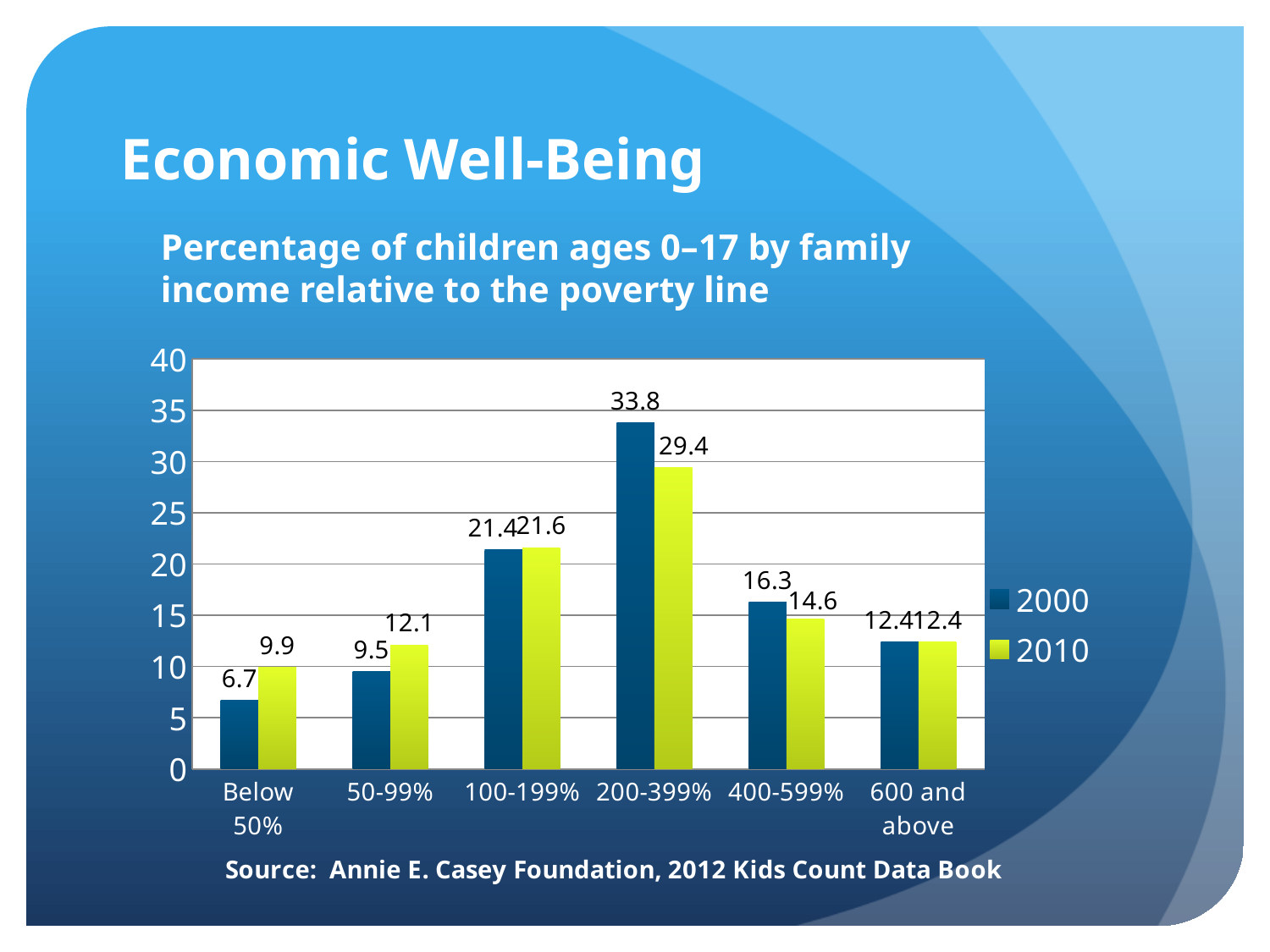
How many series does the legend list? 2 What is the value for the 2000 series in the 400-599% category? 16.3 How many income categories are shown on the x axis? 6 What is the difference between the 2010 and 2000 values in the 50-99% category? 2.6 Which category has the lowest value for the 2000 series? Below 50% What is the difference between the 2000 and 2010 values in the 200-399% category? 4.4 Which is larger in the 400-599% category, the 2000 value or the 2010 value? 2000 What is the value for the 2000 series in the 200-399% category? 33.8 Which category has the highest value for the 2010 series? 200-399% What is the value for the 2010 series in the Below 50% category? 9.9 What kind of chart is shown on the slide? Bar chart Which series is shown in dark blue in the legend? 2000